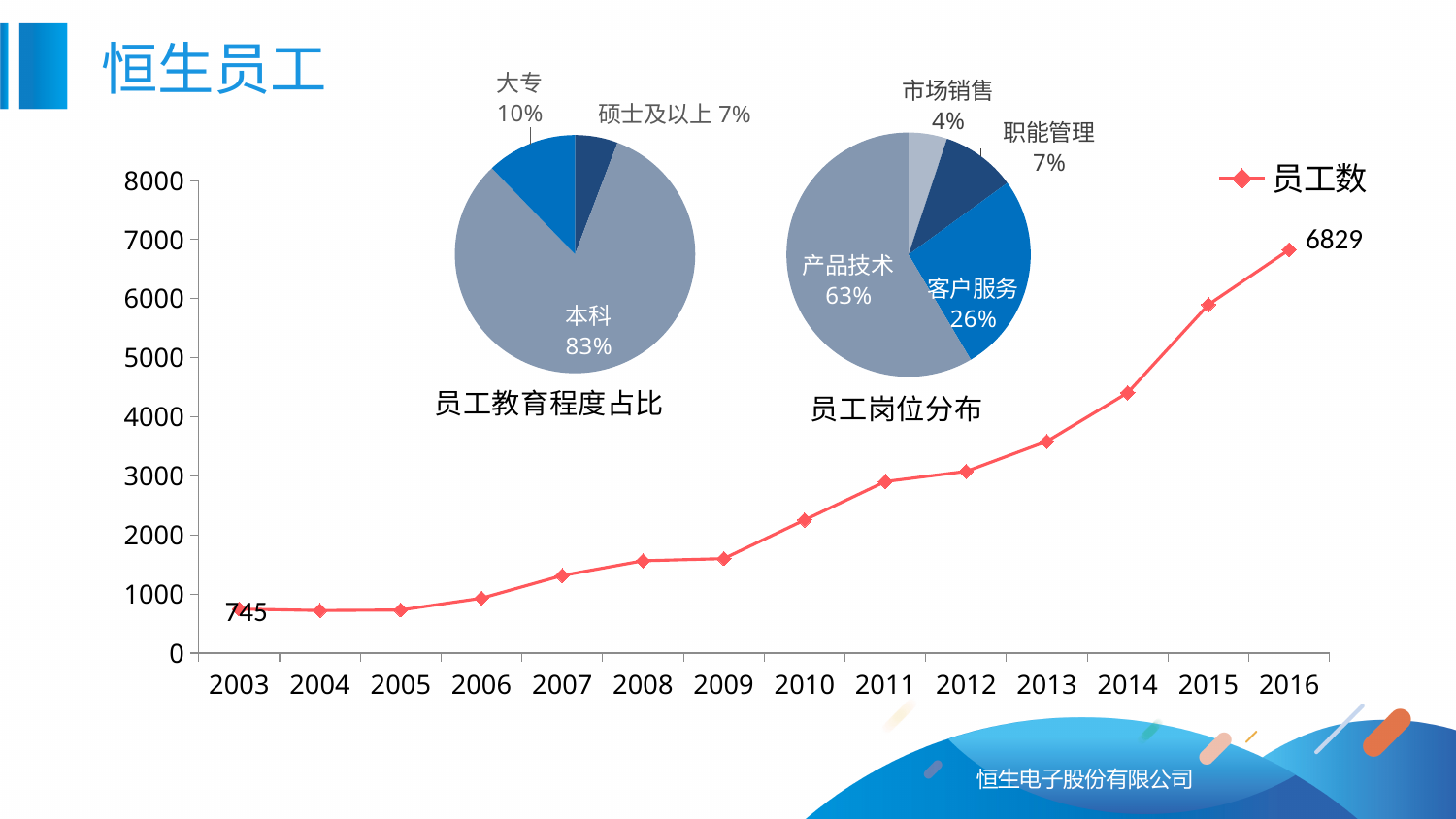
In the 员工教育程度占比 pie chart, what share is 本科? 83% In the line chart, what is the value for 员工数 in 2016? 6829 In the line chart, does 员工数 rise or fall from 2003 to 2016? rise In the 员工教育程度占比 pie chart, which category has the smallest share? 硕士及以上 In the 员工岗位分布 pie chart, what is the difference between the shares of 产品技术 and 客户服务? 37% In the line chart, what is the value for 员工数 in 2003? 745 In the line chart, how many years are shown on the x axis? 14 In the 员工岗位分布 pie chart, what share is 客户服务? 26% In the line chart, by how much did 员工数 increase from 2003 to 2016? 6084 In the line chart, is the value for 2010 greater or less than 3000? less In the line chart, is the value for 2014 greater or less than 4000? greater In the line chart, which year has the highest 员工数? 2016